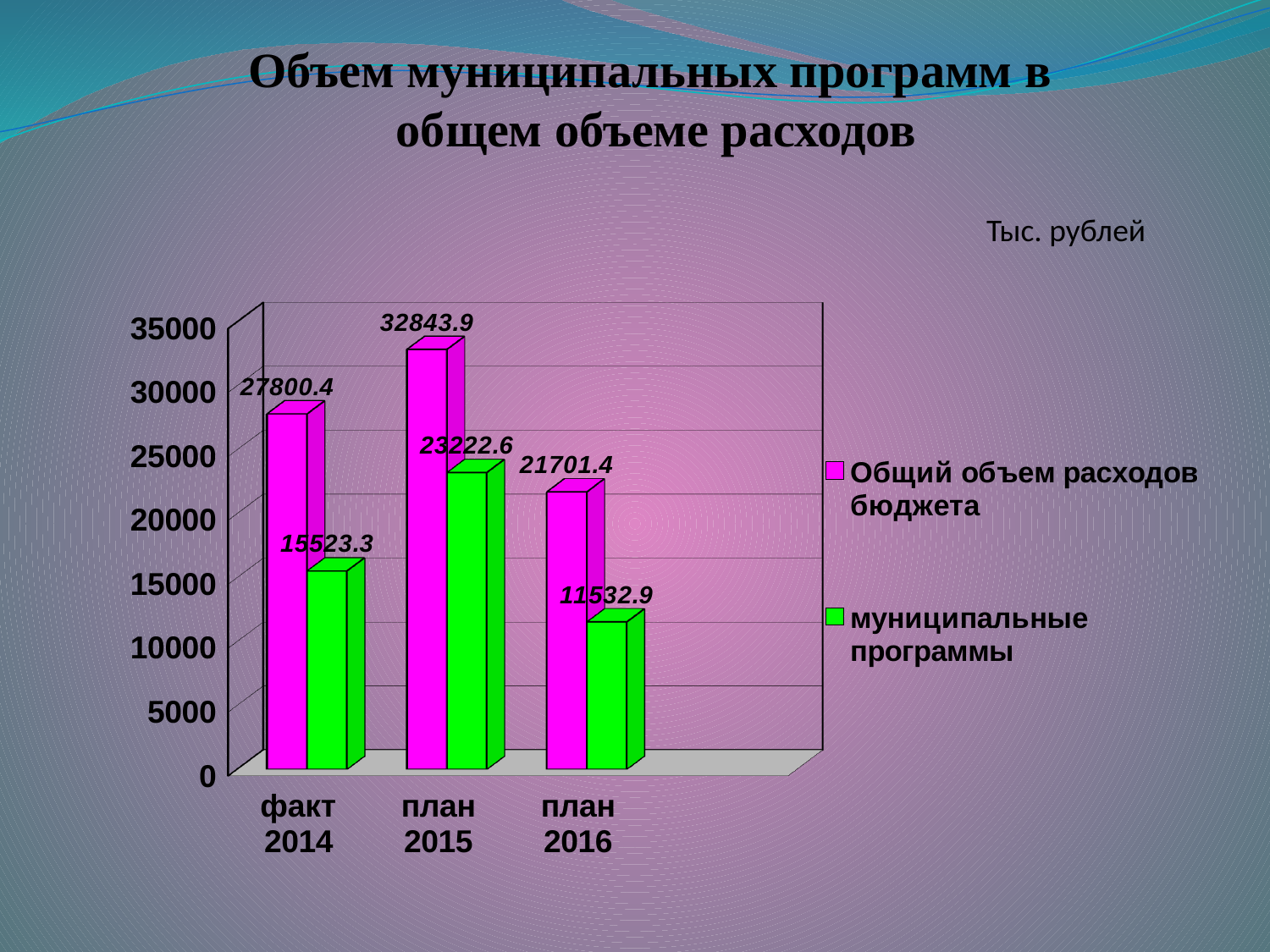
What unit is stated for the values on the chart? Тыс. рублей In which category is муниципальные программы lowest? план 2016 What is the value of муниципальные программы for план 2015? 23222.6 What kind of chart is shown on the slide? bar chart In which category is Общий объем расходов бюджета highest? план 2015 What is the difference between Общий объем расходов бюджета and муниципальные программы for план 2016? 10168.5 What is the value of Общий объем расходов бюджета for факт 2014? 27800.4 Which is larger: муниципальные программы for план 2015 or Общий объем расходов бюджета for план 2016? муниципальные программы for план 2015 How many series does the legend list? 2 Is the value of Общий объем расходов бюджета for факт 2014 greater or less than 25000? greater How many categories are shown on the x axis? 3 What is the value of муниципальные программы for план 2016? 11532.9